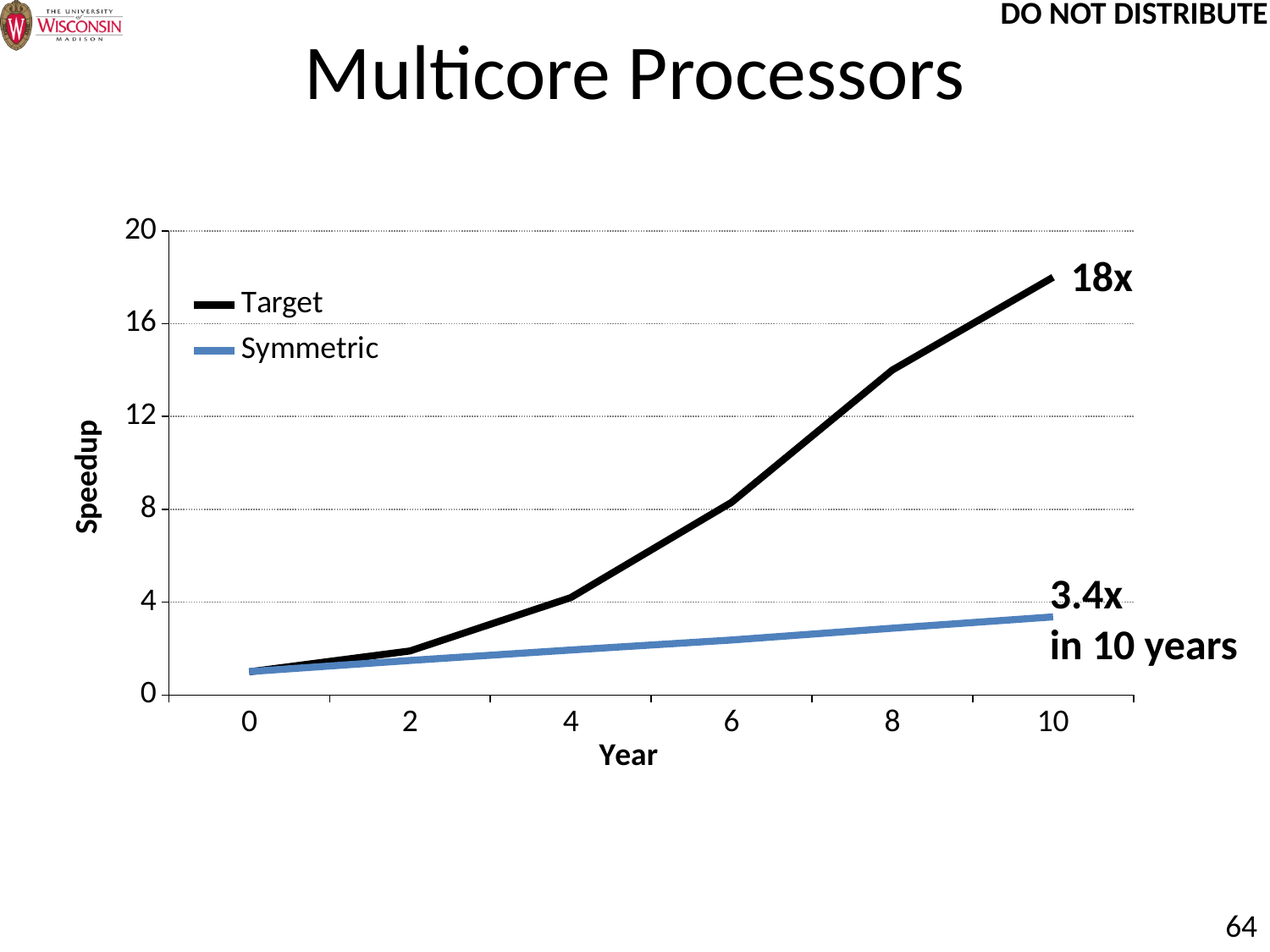
Is the Target speedup at year 4 greater or less than 8? less Does the Target series rise or fall as the year increases? rise At year 10, which series has the higher speedup, Target or Symmetric? Target What is the title of the y axis? Speedup How many series does the legend list? 2 What speedup does the Symmetric series reach at year 10? 3.4x What speedup does the Target series reach at year 10? 18x What is the difference between the Target speedup and the Symmetric speedup at year 10? 14.6x Is the Symmetric speedup at year 6 greater or less than 4? less Is the Target speedup at year 8 greater or less than 12? greater What is the title of the x axis? Year What kind of chart is shown on the slide? line chart